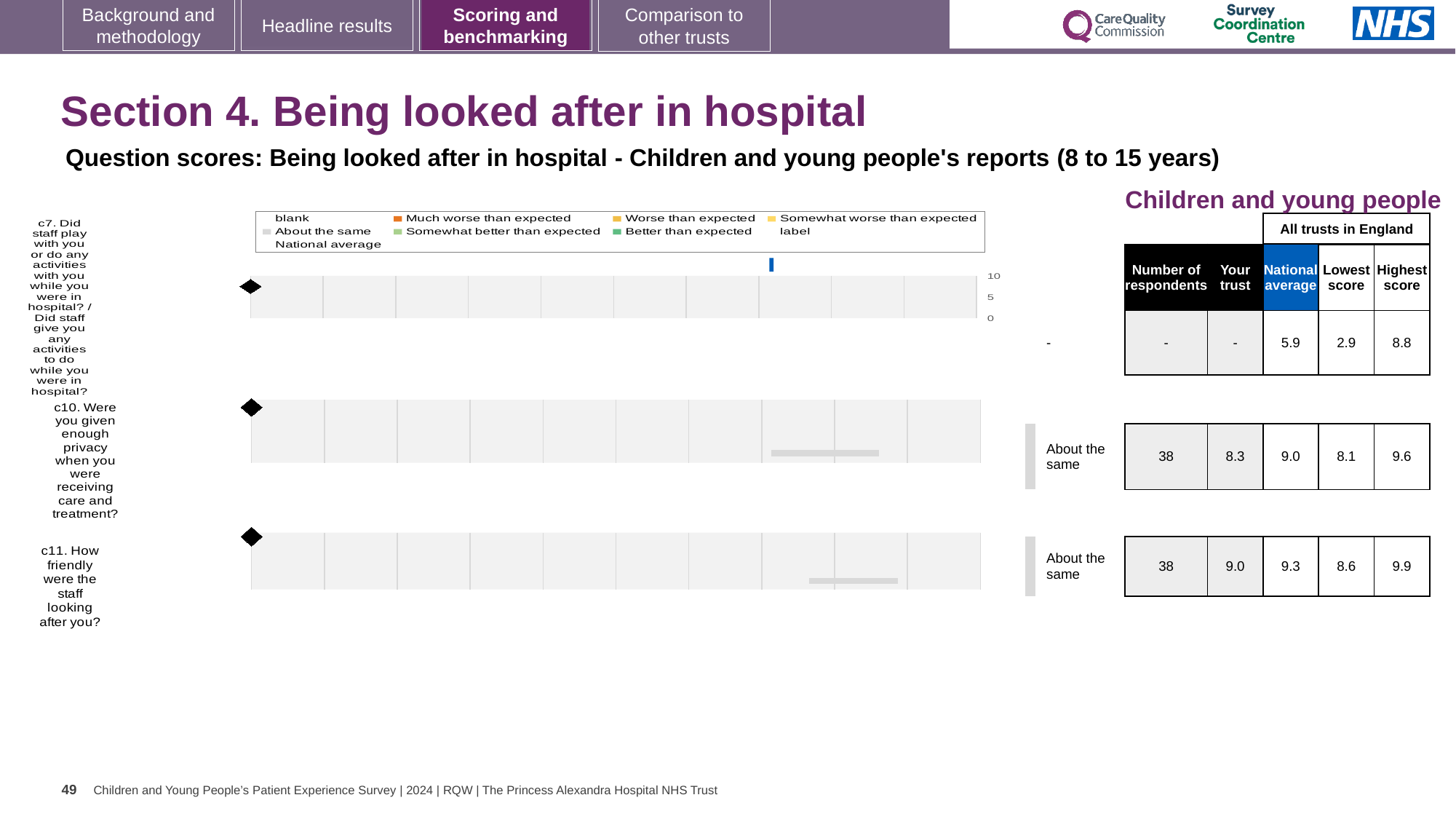
How many respondents answered c10? 38 How many questions (categories) are plotted in the chart? 3 What is the highest score across all trusts in England for c11? 9.9 What kind of chart is used to show the question scores on this slide? bar chart Which question has the highest national average: c7, c10 or c11? c11 What is the difference between the national average and the 'Your trust' score for c10? 0.7 How many entries does the chart legend list? 9 What is the 'Your trust' score for c11 (How friendly were the staff looking after you?)? 9.0 What is the national average for c7 (Did staff play with you or do any activities with you while you were in hospital?)? 5.9 What is the 'Your trust' score for c10 (Were you given enough privacy when you were receiving care and treatment?)? 8.3 What is the lowest score across all trusts in England for c10? 8.1 Is the 'Your trust' score for c11 larger or smaller than the national average for c11? smaller